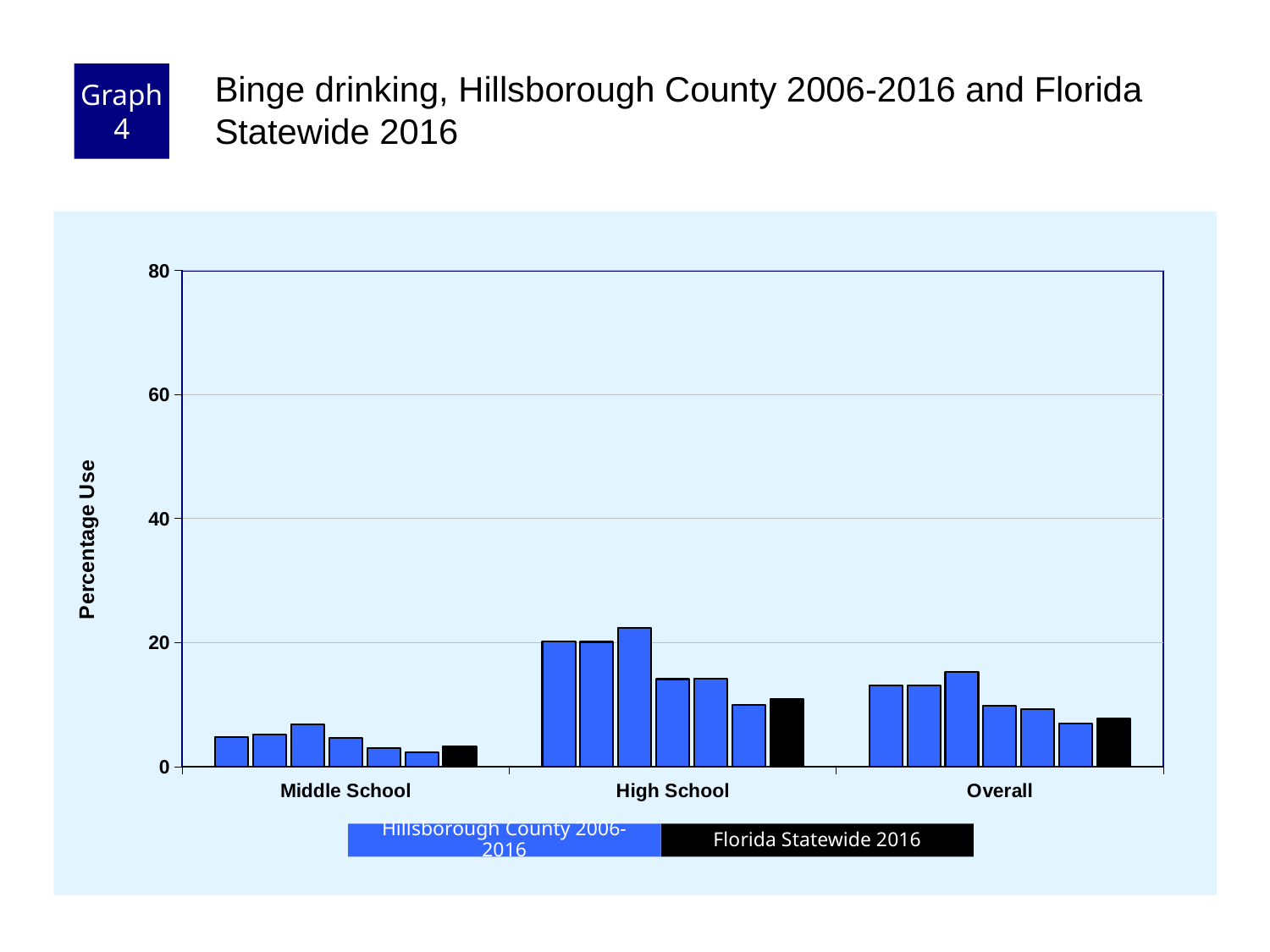
Which is larger: the Florida Statewide 2016 value for Overall or the Florida Statewide 2016 value for Middle School? Overall Is the Florida Statewide 2016 value for Middle School greater or less than 20? less Is the Florida Statewide 2016 value for High School greater or less than 20? less Is the tallest Hillsborough County bar for High School greater or less than 40? less Which category has the highest bars in the chart? High School Which category has the lowest bars in the chart? Middle School How many series does the chart legend list? 2 What is the label on the y axis of the chart? Percentage Use How many categories are shown on the x axis of the chart? 3 Which is larger: the Florida Statewide 2016 value for High School or the Florida Statewide 2016 value for Middle School? High School What kind of chart is shown on the slide? bar chart What is the title of the chart on the slide? Binge drinking, Hillsborough County 2006-2016 and Florida Statewide 2016